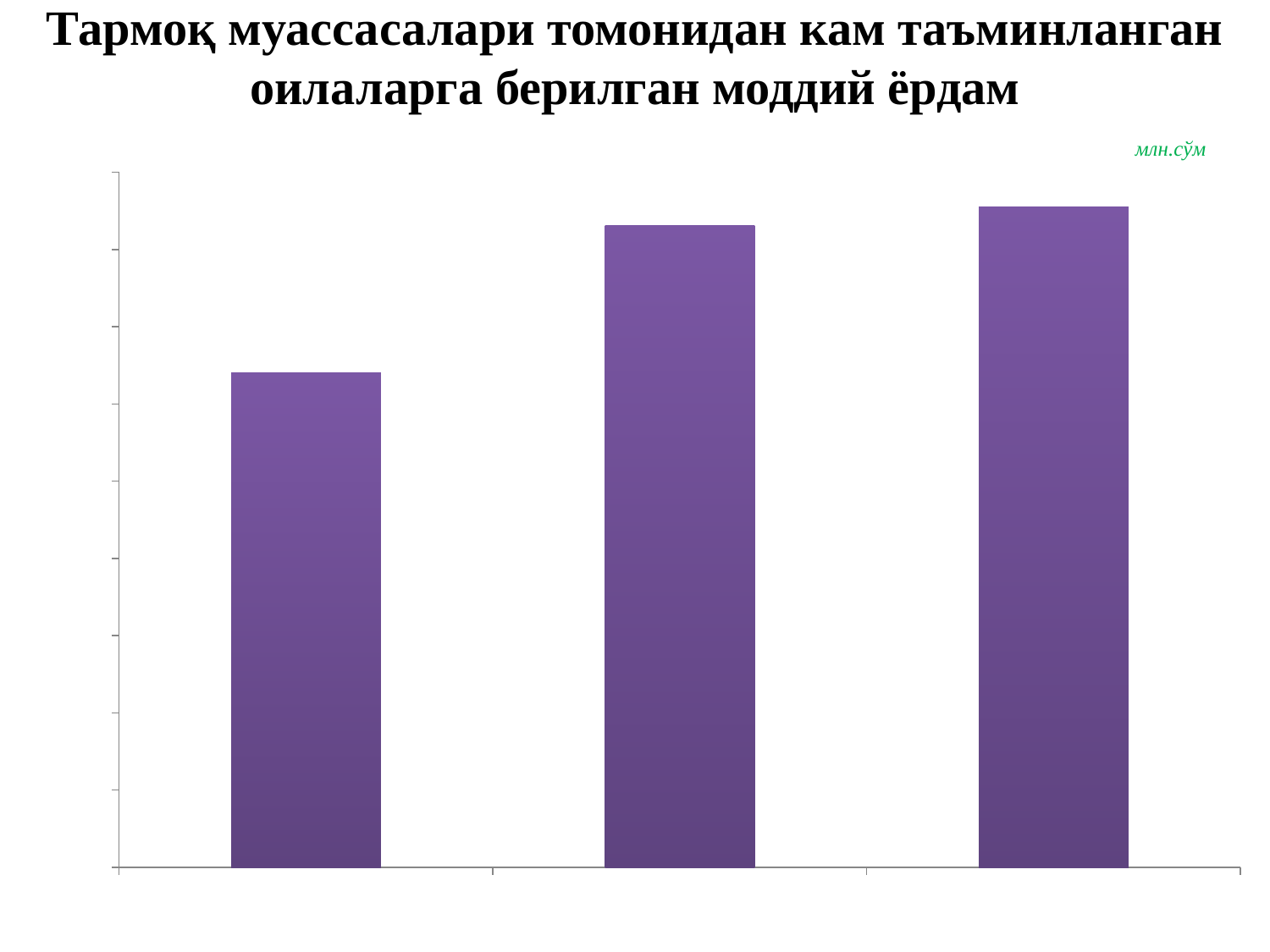
Is the middle bar or the right bar taller? right Is the left bar or the middle bar taller? middle Which bar is the shortest: the left, middle, or right one? left Which bar is the tallest: the left, middle, or right one? right How many bars are plotted in the chart? 3 What unit is indicated in the top-right corner of the chart? млн.сўм Do the bar values rise or fall from left to right across the chart? rise What kind of chart is shown on the slide? bar chart What is the title of the chart on the slide? Тармоқ муассасалари томонидан кам таъминланган оилаларга берилган моддий ёрдам